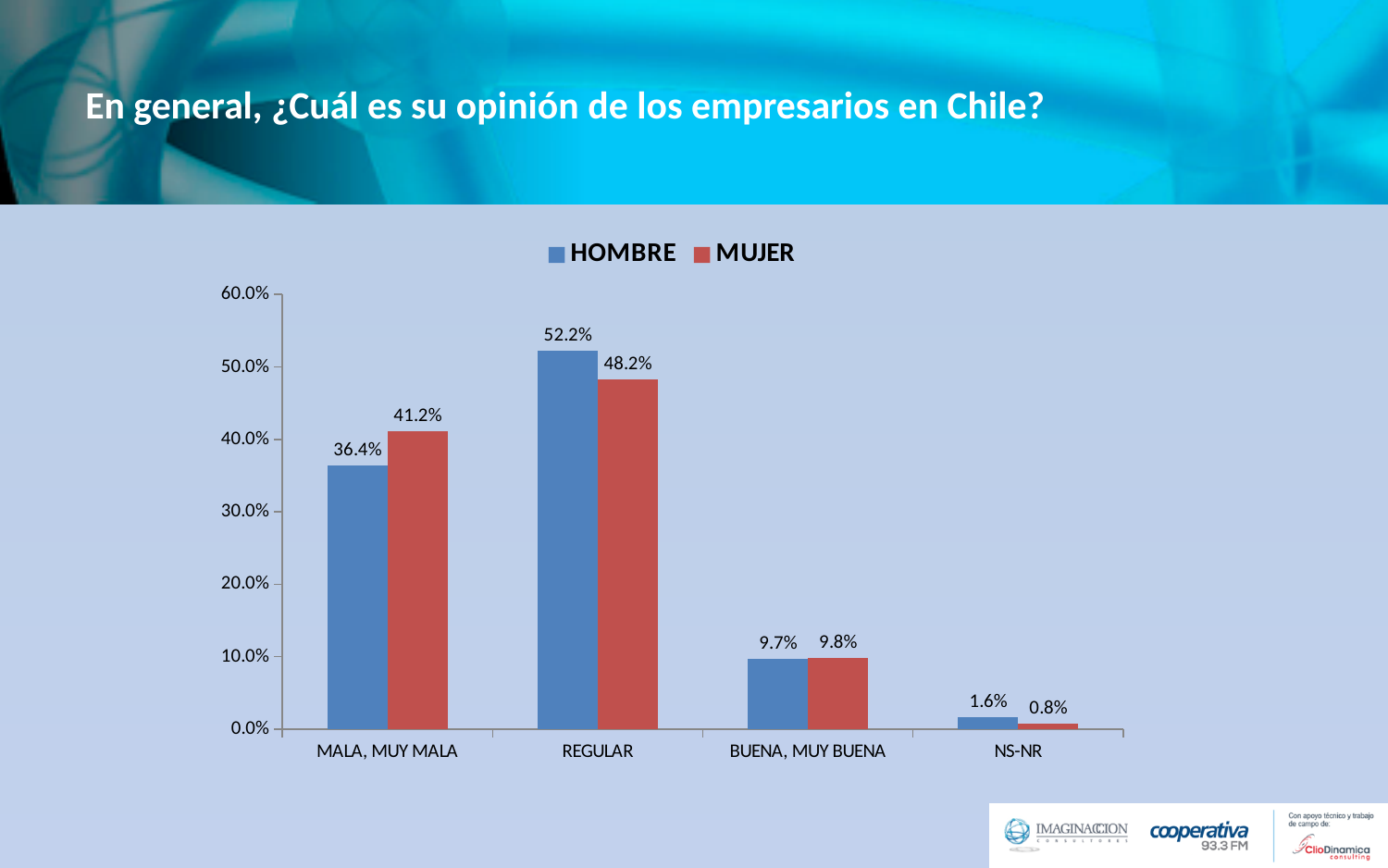
How many series does the legend list? 2 In the MALA, MUY MALA category, which series has the larger value, HOMBRE or MUJER? MUJER What is the value for MUJER in the NS-NR category? 0.8% What is the difference between the MUJER and HOMBRE values in the MALA, MUY MALA category? 4.8% Which category has the highest value for HOMBRE? REGULAR What is the value for HOMBRE in the REGULAR category? 52.2% Which colour represents the MUJER series? Red Which category has the lowest value for MUJER? NS-NR What kind of chart is shown on the slide? Bar chart How many categories are shown on the x axis? 4 What is the value for MUJER in the MALA, MUY MALA category? 41.2% What is the difference between the HOMBRE and MUJER values in the REGULAR category? 4.0%